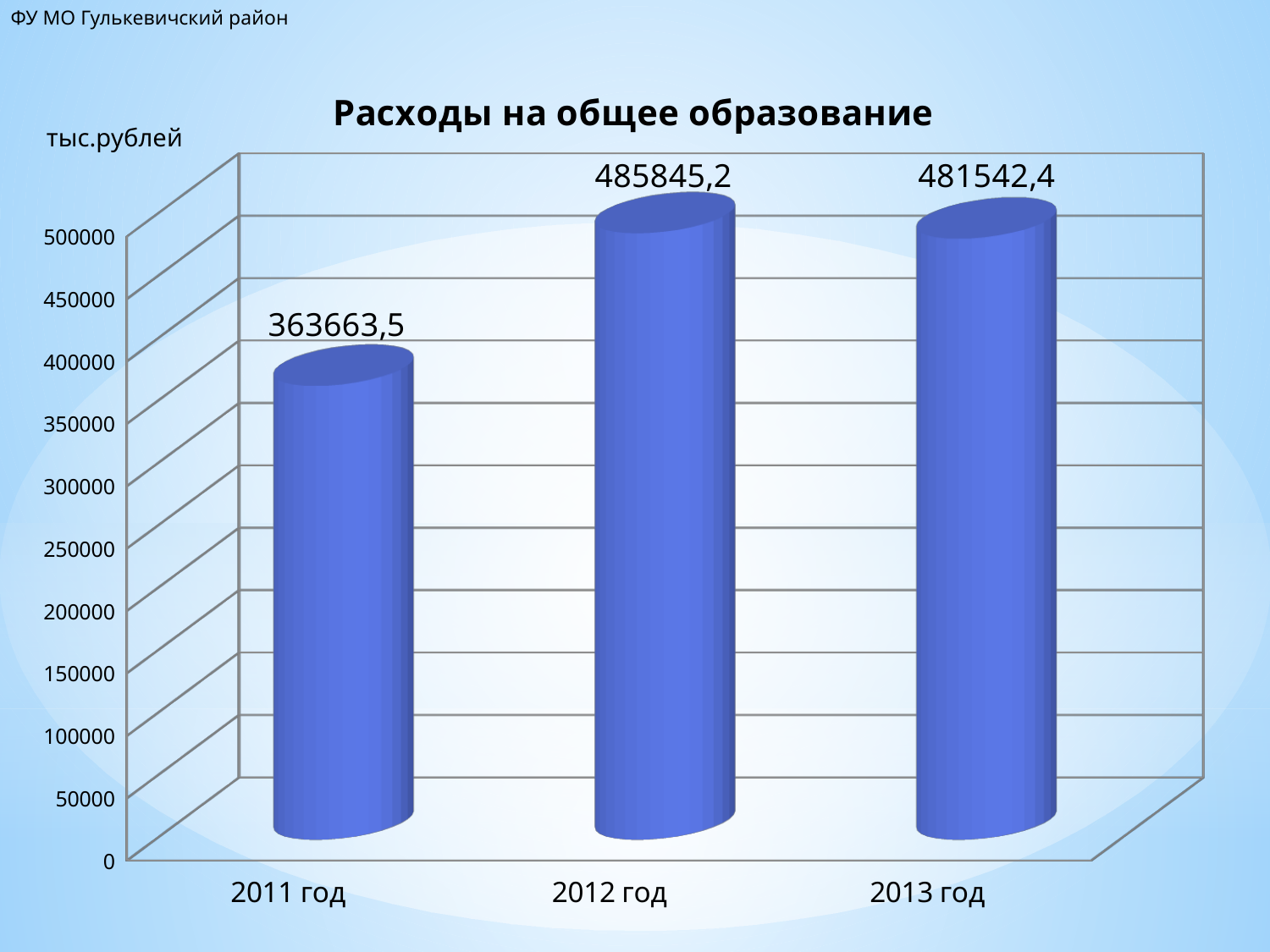
What is the difference between the values for 2012 год and 2013 год? 4302,8 What is the title of the chart? Расходы на общее образование Which year has the highest value? 2012 год What is the value for 2013 год? 481542,4 What is the value for 2012 год? 485845,2 Is the value for 2011 год greater or less than 400000? less What kind of chart is this? bar chart What is the value for 2011 год? 363663,5 What is the difference between the values for 2012 год and 2011 год? 122181,7 How many years are shown on the chart? 3 Which year has the lowest value? 2011 год Which is larger, the value for 2013 год or the value for 2011 год? 2013 год